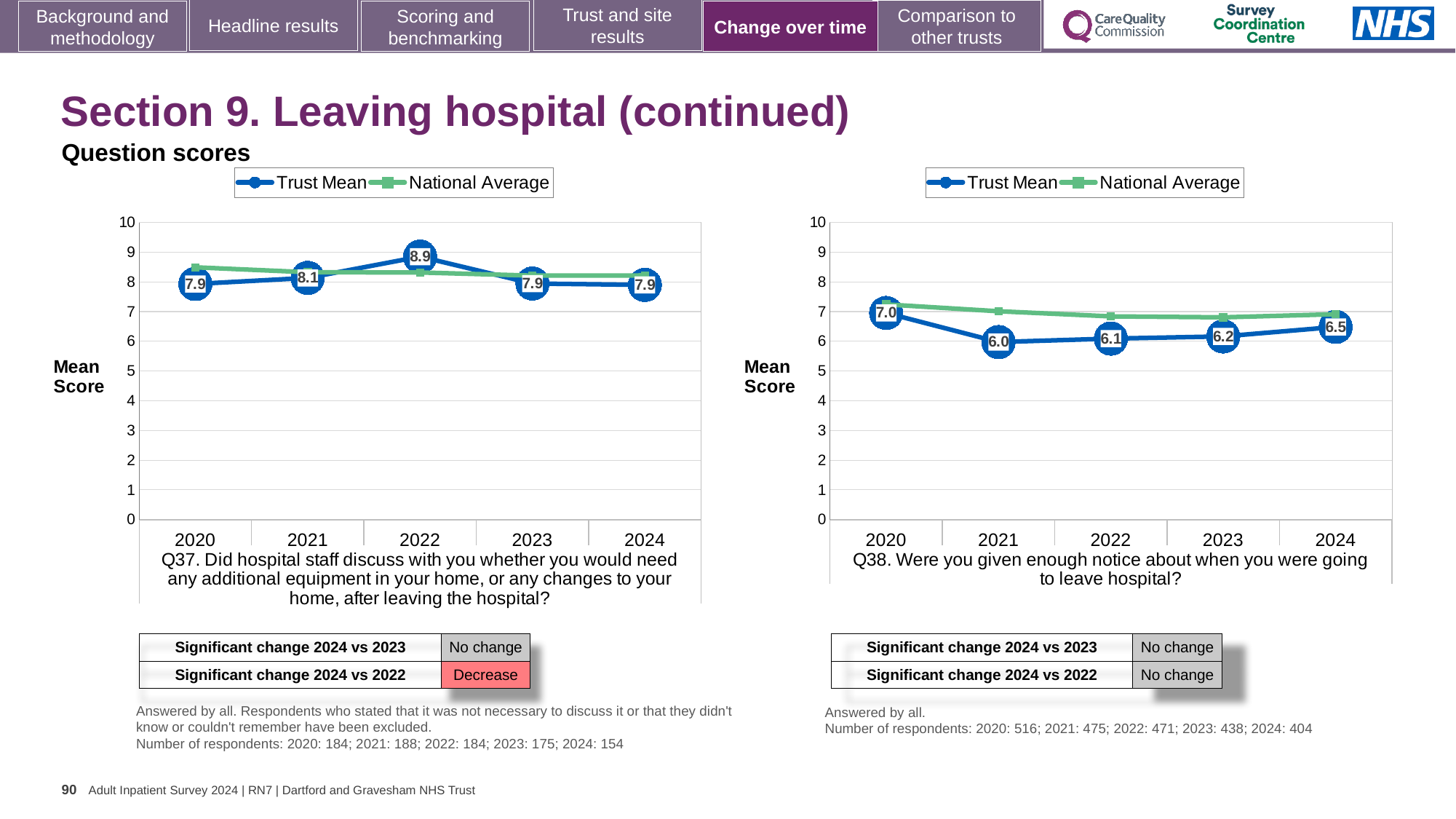
What type of chart is used for Q37 (left)? Line chart In the Q37 chart (left), what is the Trust Mean score for 2022? 8.9 How many series does the legend of the Q38 chart (right) list? 2 In the Q38 chart (right), is the Trust Mean score higher in 2020 or in 2024? 2020 In the Q38 chart (right), what is the difference between the Trust Mean scores for 2020 and 2021? 1.0 In the Q38 chart (right), which year has the lowest Trust Mean score? 2021 In the Q37 chart (left), which year has the highest Trust Mean score? 2022 How many years are plotted on the x axis of the Q37 chart (left)? 5 In the Q38 chart (right), does the Trust Mean rise or fall from 2021 to 2024? Rise In the Q37 chart (left), what is the difference between the Trust Mean scores for 2022 and 2023? 1.0 In the Q38 chart (right), what is the Trust Mean score for 2021? 6.0 In the Q38 chart (right), is the National Average for 2020 greater or less than 7? greater